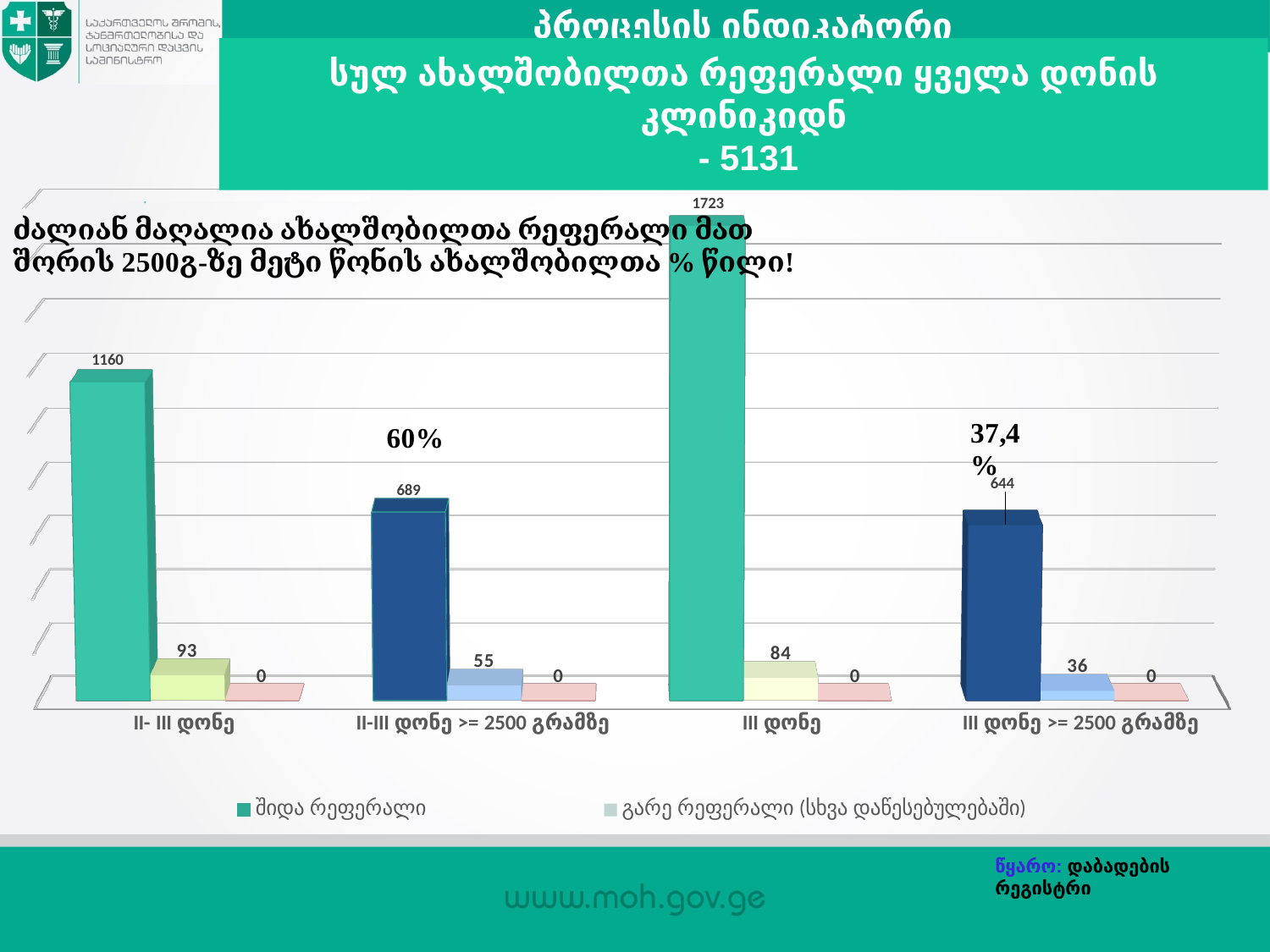
What percentage label is shown above the II-III დონე >= 2500 გრამზე bar? 60% How many series does the chart legend list? 2 Which category has the highest value of შიდა რეფერალი? III დონე Which category has the lowest value of გარე რეფერალი (სხვა დაწესებულებაში)? III დონე >= 2500 გრამზე How many categories are shown on the x axis of the chart? 4 Which is larger: the შიდა რეფერალი value for II-III დონე >= 2500 გრამზე or for III დონე >= 2500 გრამზე? II-III დონე >= 2500 გრამზე What is the difference between the შიდა რეფერალი values for III დონე and II- III დონე? 563 What is the value of შიდა რეფერალი for the category II- III დონე? 1160 What type of chart is shown on the slide? bar chart What is the value of გარე რეფერალი (სხვა დაწესებულებაში) for the category II-III დონე >= 2500 გრამზე? 55 What is the value of შიდა რეფერალი for the category III დონე? 1723 What is the value of გარე რეფერალი (სხვა დაწესებულებაში) for the category III დონე >= 2500 გრამზე? 36